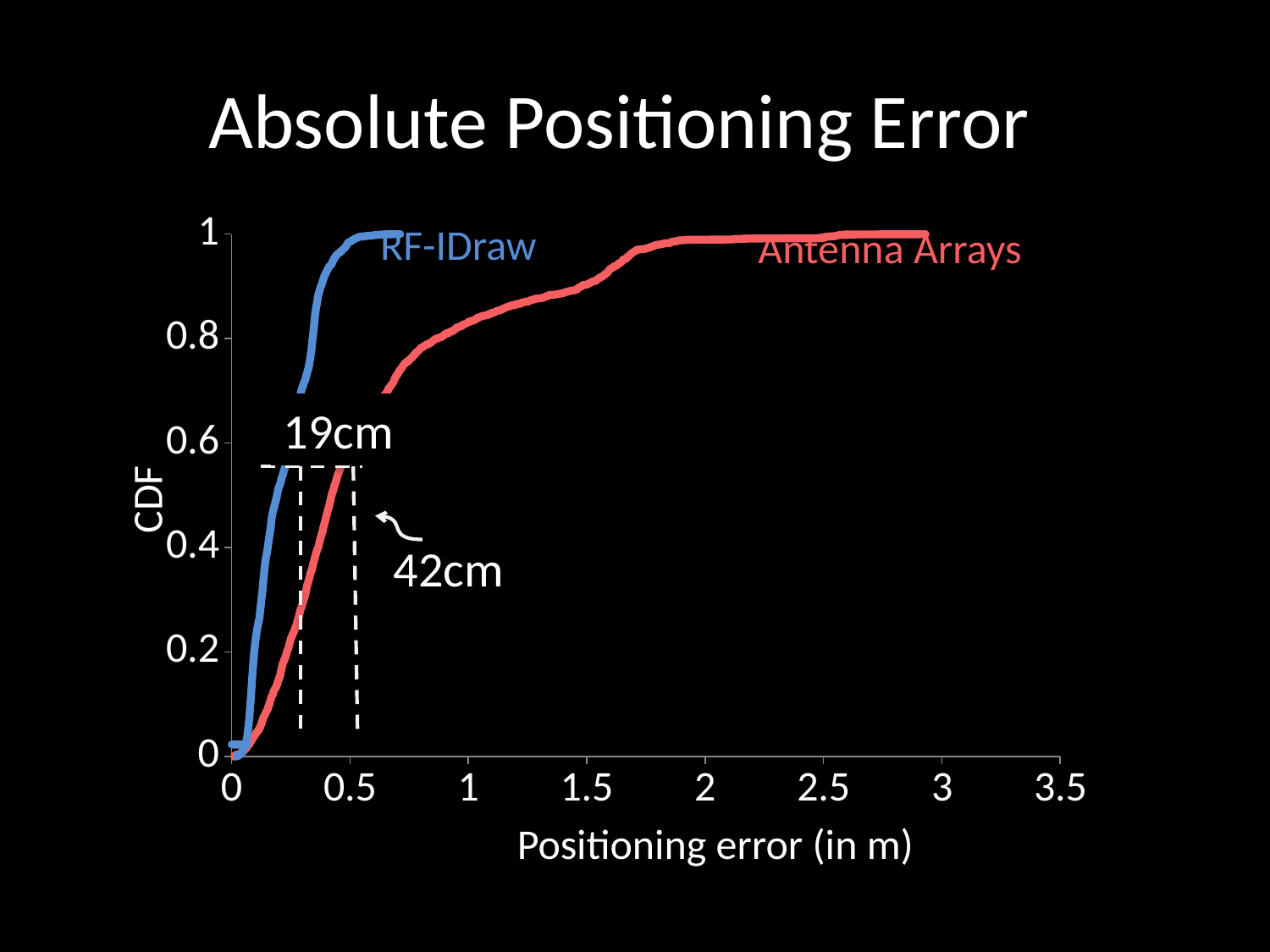
What kind of chart is shown on the slide? Line chart What is the label of the x axis? Positioning error (in m) How many series are plotted in the chart? 2 What is the title of the chart? Absolute Positioning Error Which series has the larger annotated positioning error, RF-IDraw or Antenna Arrays? Antenna Arrays At a positioning error of 0.5 m, is the CDF for Antenna Arrays greater or less than 0.8? less Which series reaches a CDF of 1 at a smaller positioning error, RF-IDraw or Antenna Arrays? RF-IDraw What is the difference between the two annotated positioning errors? 23cm What positioning error is annotated for the RF-IDraw curve? 19cm What positioning error is annotated for the Antenna Arrays curve? 42cm At a positioning error of 1.5 m, is the CDF for Antenna Arrays greater or less than 0.8? greater Do the CDF curves rise or fall as positioning error increases along the x axis? Rise